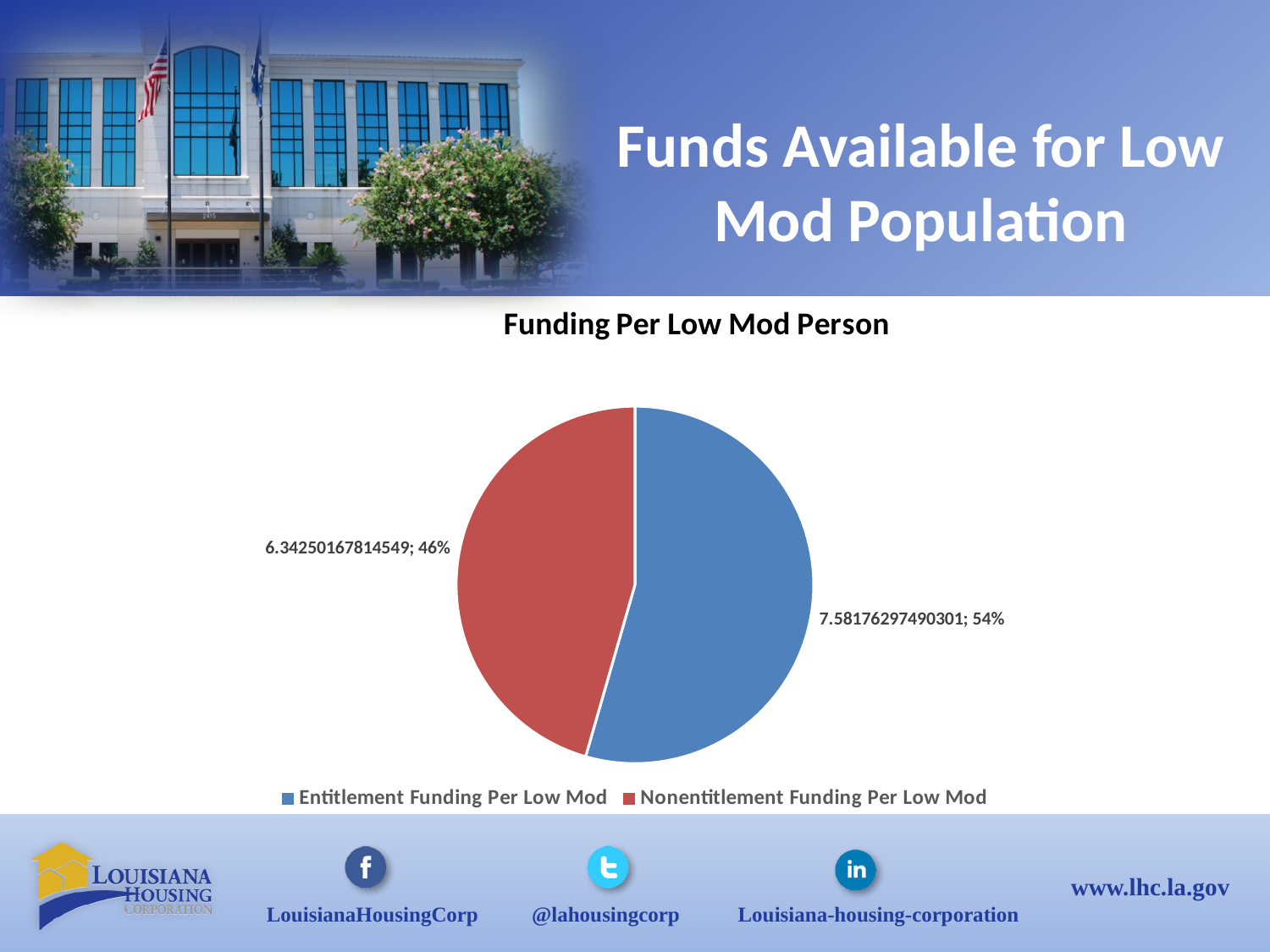
What share of the pie does Nonentitlement Funding Per Low Mod represent? 46% Which is larger, Entitlement Funding Per Low Mod or Nonentitlement Funding Per Low Mod? Entitlement Funding Per Low Mod How many slices does the pie chart have? 2 Which slice is the smallest in the pie chart? Nonentitlement Funding Per Low Mod What value is shown for Entitlement Funding Per Low Mod? 7.58176297490301 What is the title of the chart? Funding Per Low Mod Person What value is shown for Nonentitlement Funding Per Low Mod? 6.34250167814549 What type of chart is shown on the slide? Pie chart How many entries does the legend list? 2 What share of the pie does Entitlement Funding Per Low Mod represent? 54% What colour is the Nonentitlement Funding Per Low Mod slice? Red Which slice is the largest in the pie chart? Entitlement Funding Per Low Mod